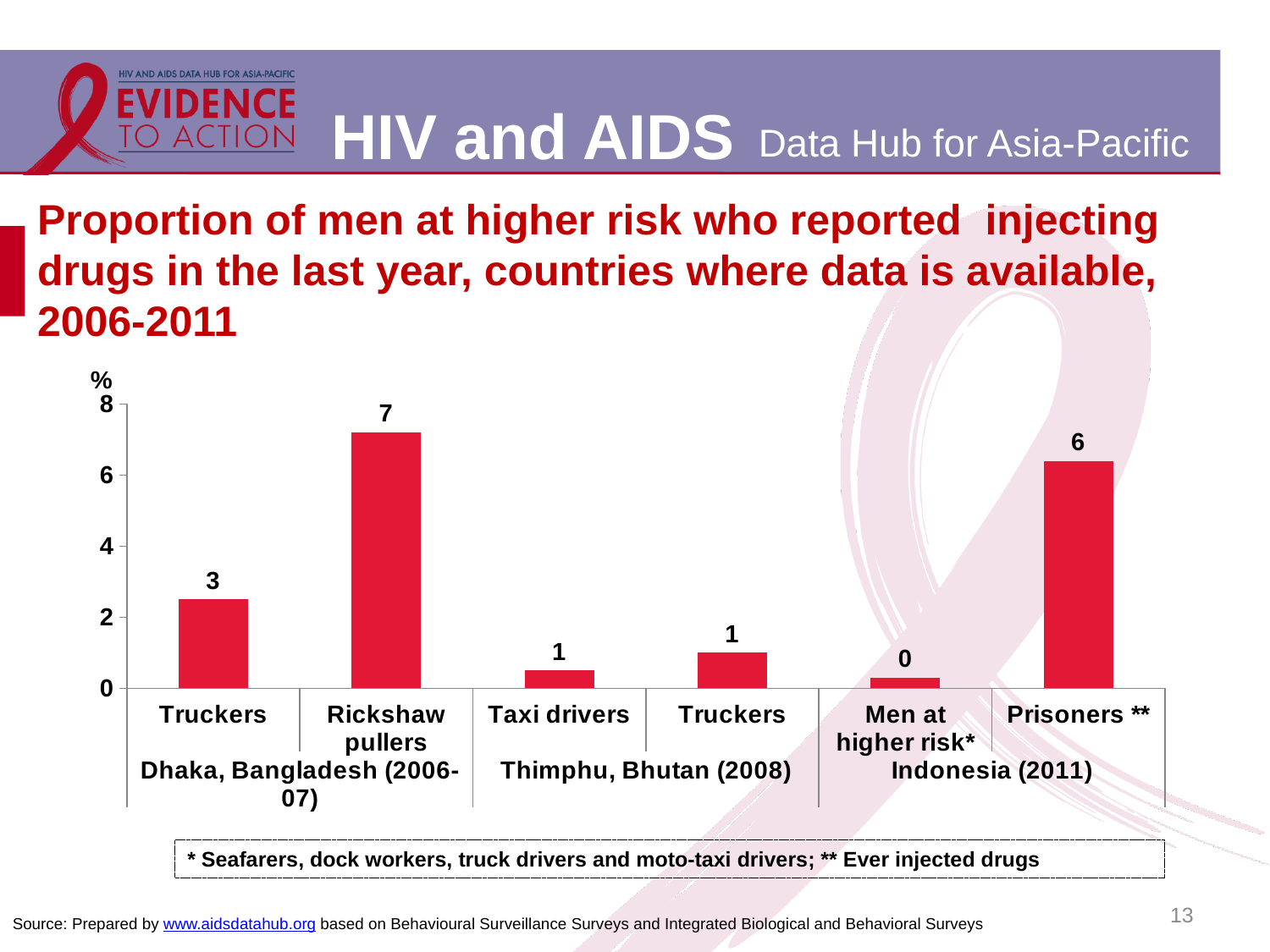
What value is shown for Men at higher risk in Indonesia (2011)? 0 What value is shown for Rickshaw pullers in Dhaka, Bangladesh (2006-07)? 7 What unit is shown at the top of the vertical axis? % What is the difference between the labelled values for Rickshaw pullers and Truckers in Dhaka, Bangladesh? 4 What kind of chart is shown on the slide? Bar chart Which category has the highest value in the chart? Rickshaw pullers (Dhaka, Bangladesh) How many bars are plotted in the chart? 6 What value is shown for Truckers in Dhaka, Bangladesh (2006-07)? 3 Is the value for Rickshaw pullers in Dhaka, Bangladesh greater or less than 6? greater Which category has the lowest value in the chart? Men at higher risk (Indonesia) What value is shown for Prisoners in Indonesia (2011)? 6 Which is larger: the value for Prisoners in Indonesia or the value for Truckers in Dhaka, Bangladesh? Prisoners in Indonesia